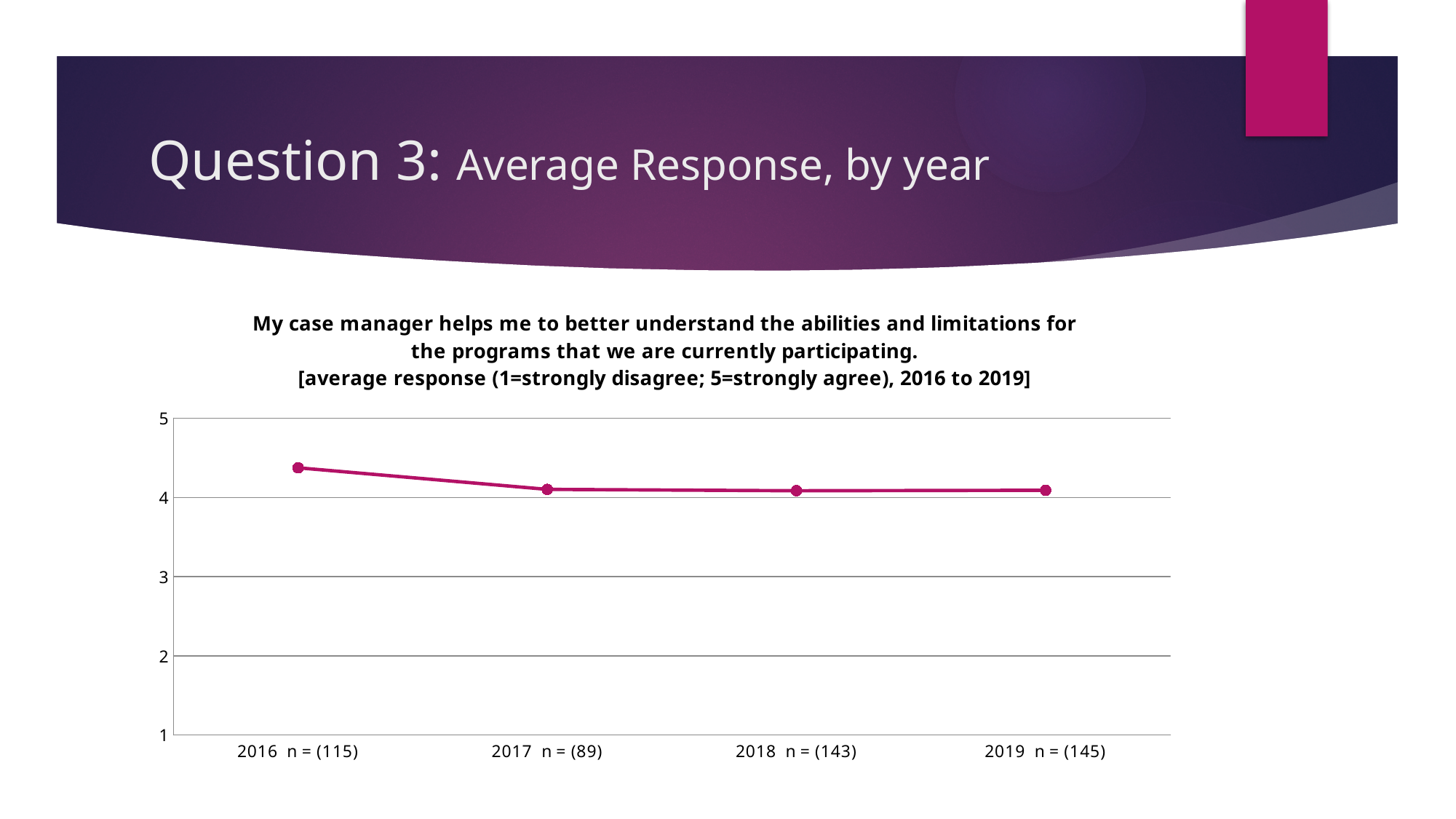
Is the average response for 2016 greater or less than 4? greater Is the average response for 2016 higher or lower than the average response for 2017? higher Which year has the highest average response? 2016 Is the average response for 2019 greater or less than 3? greater What is the sample size (n) shown for 2017? 89 What kind of chart is shown on the slide? line chart Is the average response for 2017 greater or less than 4? greater How many years (data points) are plotted on the chart? 4 What is the sample size (n) shown for 2019? 145 Does the average response rise or fall from 2016 to 2017? fall